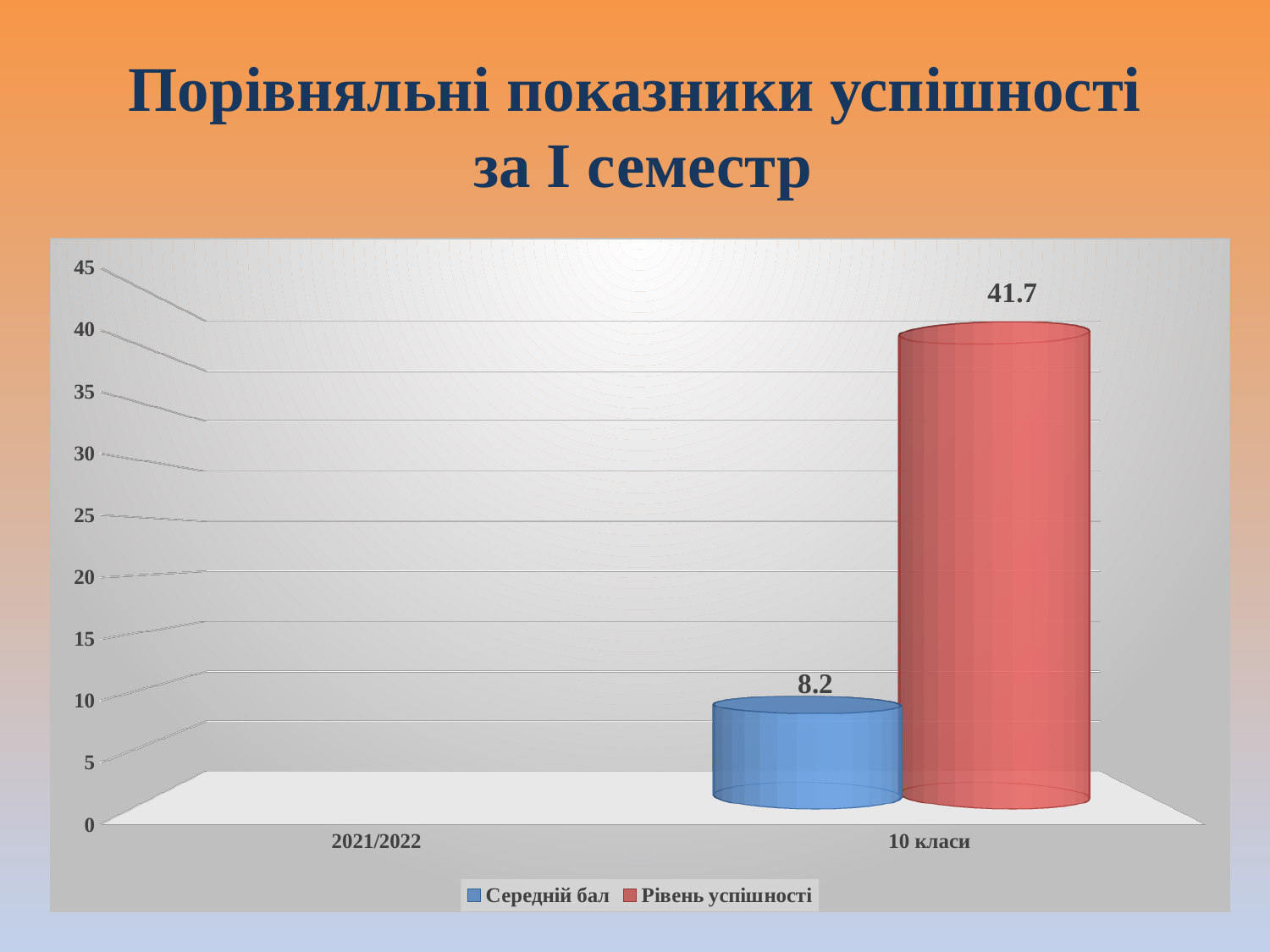
What kind of chart is shown on the slide? bar chart Which series has the higher value for 10 класи, Середній бал or Рівень успішності? Рівень успішності Is the value of Середній бал for 10 класи greater or less than 10? less What is the value of Середній бал for 10 класи? 8.2 What is the difference between Рівень успішності and Середній бал for 10 класи? 33.5 How many category labels appear on the x axis? 2 What is the highest value shown on the vertical axis? 45 Is the value of Рівень успішності for 10 класи greater or less than 40? greater What is the title of the slide? Порівняльні показники успішності за І семестр How many series does the legend list? 2 What colour is the bar for Рівень успішності? red What is the value of Рівень успішності for 10 класи? 41.7